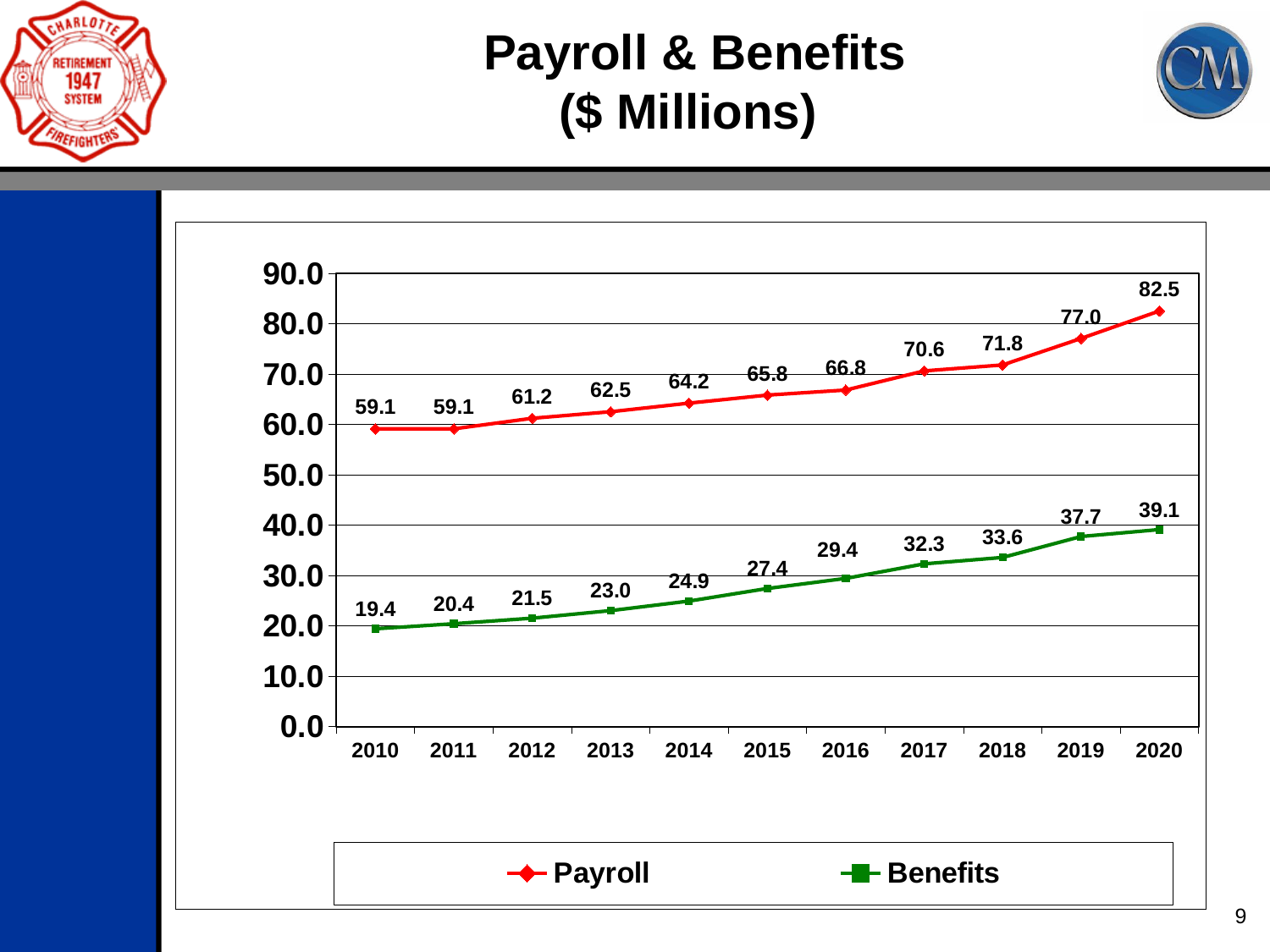
Which is larger in 2016, the Payroll value or the Benefits value? Payroll What is the Payroll value for 2013? 62.5 What is the Payroll value for 2020? 82.5 How many years are shown on the x axis? 11 What is the Benefits value for 2015? 27.4 By how much did Benefits increase from 2010 to 2020? 19.7 Do the Benefits values rise or fall from 2010 to 2020? Rise What kind of chart is shown on the slide? Line chart What is the difference between the Payroll and Benefits values in 2020? 43.4 How many series does the legend list? 2 In which year is the Payroll value highest? 2020 In which year is the Benefits value lowest? 2010